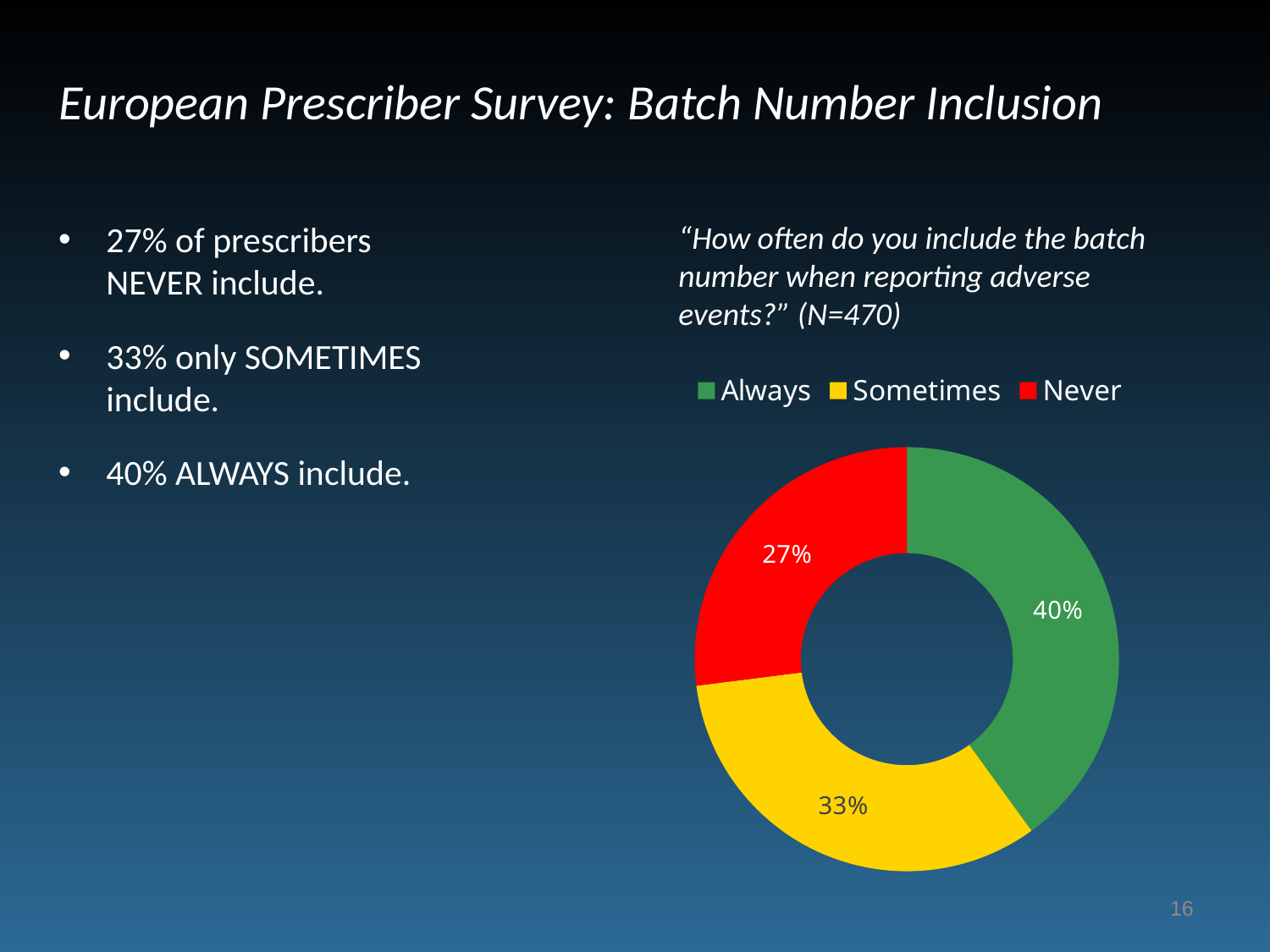
What percentage of prescribers answered "Sometimes"? 33% Which is larger, the share for "Sometimes" or the share for "Never"? Sometimes What is the sample size (N) stated for the survey question above the chart? 470 What percentage of prescribers answered "Never"? 27% What is the difference in percentage points between the "Always" and "Never" shares? 13 What kind of chart is shown on the slide? Doughnut (pie) chart How many categories does the chart show? 3 What colour represents the "Never" category in the chart? Red What percentage of prescribers answered "Always"? 40% Which response has the largest share of the chart? Always Which response has the smallest share of the chart? Never What is the difference in percentage points between the "Sometimes" and "Never" shares? 6